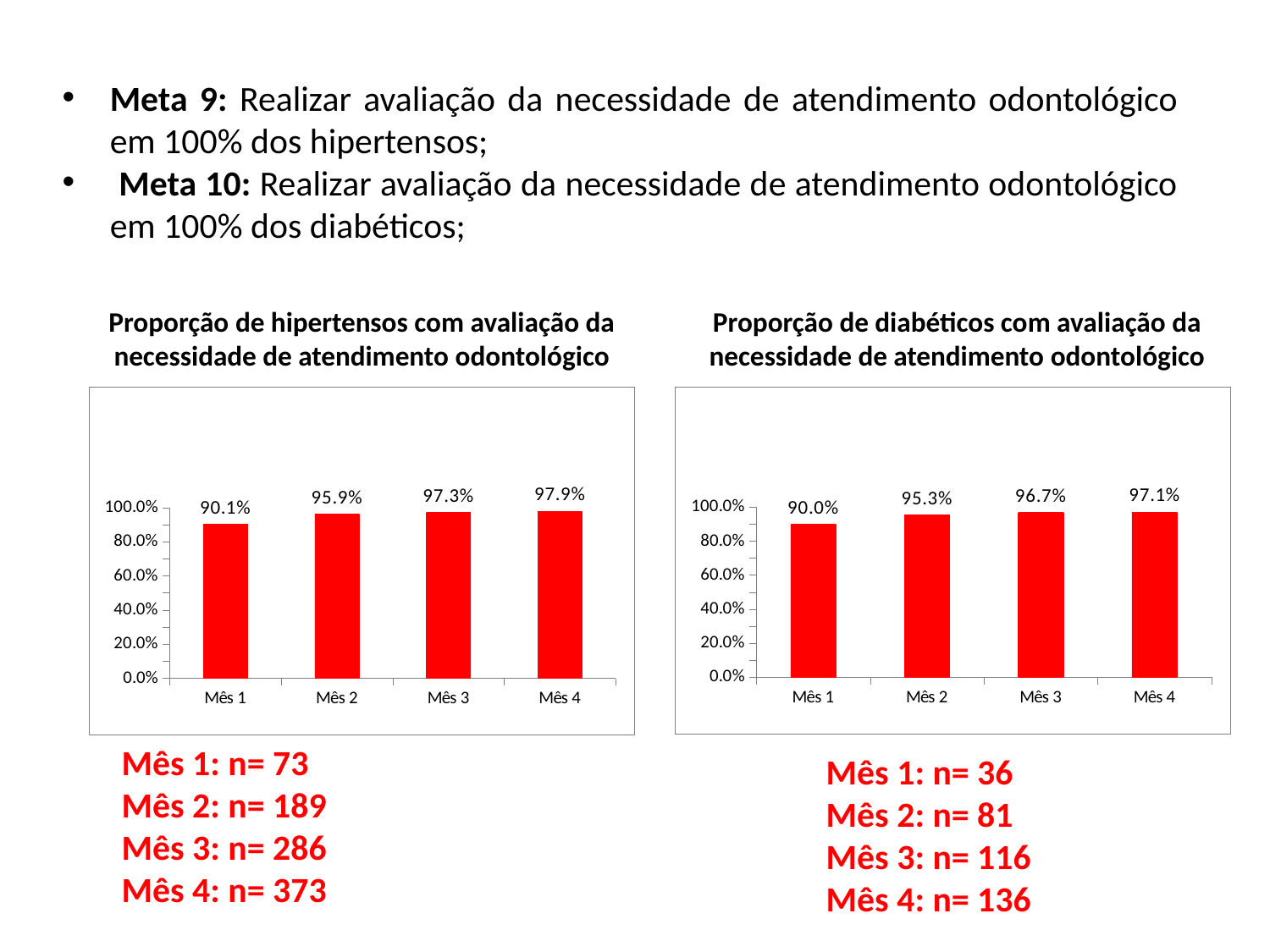
Is the value for Mês 2 in the chart 'Proporção de hipertensos com avaliação da necessidade de atendimento odontológico' larger than the value for Mês 2 in the chart 'Proporção de diabéticos com avaliação da necessidade de atendimento odontológico'? Yes, 95.9% vs 95.3% In the chart 'Proporção de hipertensos com avaliação da necessidade de atendimento odontológico', what is the difference between the values for Mês 4 and Mês 1? 7.8% In the chart 'Proporção de diabéticos com avaliação da necessidade de atendimento odontológico', which month has the lowest value? Mês 1 In the chart 'Proporção de hipertensos com avaliação da necessidade de atendimento odontológico', which month has the highest value? Mês 4 In the chart 'Proporção de hipertensos com avaliação da necessidade de atendimento odontológico', what is the value for Mês 1? 90.1% What kind of chart is 'Proporção de diabéticos com avaliação da necessidade de atendimento odontológico'? Bar chart In the chart 'Proporção de hipertensos com avaliação da necessidade de atendimento odontológico', do the values rise or fall from Mês 1 to Mês 4? Rise What colour are the bars in the chart 'Proporção de diabéticos com avaliação da necessidade de atendimento odontológico'? Red In the chart 'Proporção de diabéticos com avaliação da necessidade de atendimento odontológico', what is the value for Mês 3? 96.7% How many months are shown in the chart 'Proporção de hipertensos com avaliação da necessidade de atendimento odontológico'? 4 In the chart 'Proporção de diabéticos com avaliação da necessidade de atendimento odontológico', is the value for Mês 1 greater or less than 80.0%? greater In the chart 'Proporção de diabéticos com avaliação da necessidade de atendimento odontológico', what is the difference between the values for Mês 2 and Mês 1? 5.3%